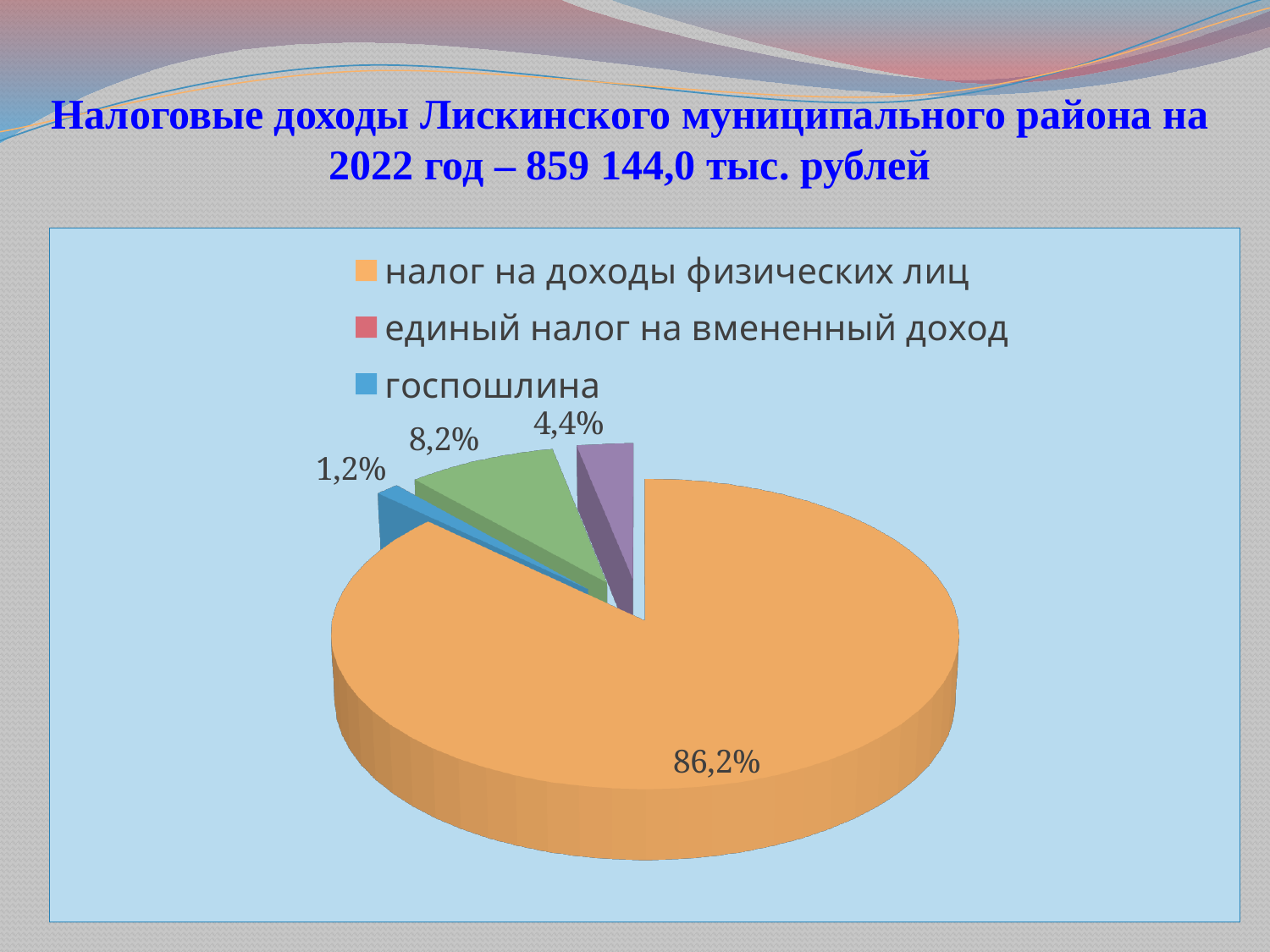
What colour is the slice for налог на доходы физических лиц? orange How many entries does the legend list? 3 What is the largest percentage label shown on the pie chart? 86,2% Which category has the smallest slice of the pie? госпошлина What share of the pie is labelled for госпошлина? 1,2% What share of the pie is labelled for налог на доходы физических лиц? 86,2% Which is larger: the slice for налог на доходы физических лиц or the slice for госпошлина? налог на доходы физических лиц What kind of chart is shown on the slide? pie chart What is the difference in percentage points between the slice for налог на доходы физических лиц and the slice for госпошлина? 85,0% How many slices does the pie chart have? 4 Which category has the largest slice of the pie? налог на доходы физических лиц What is the title of the slide above the chart? Налоговые доходы Лискинского муниципального района на 2022 год – 859 144,0 тыс. рублей